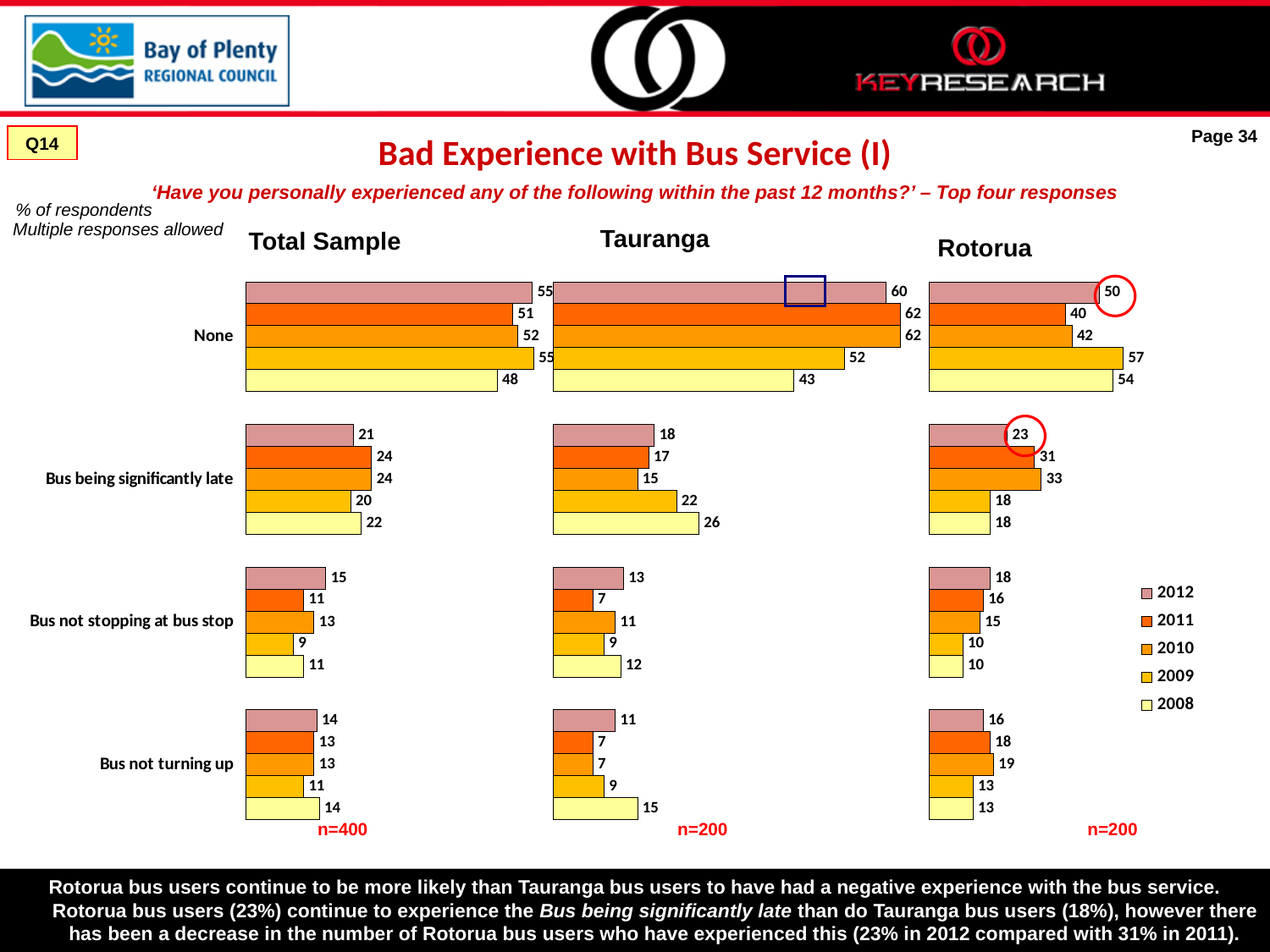
What is the sample size (n) shown under the Total Sample chart? n=400 For 'Bus being significantly late' in 2012, which is larger: the Rotorua value or the Tauranga value? Rotorua In the Total Sample chart, what is the 2009 value for 'Bus not stopping at bus stop'? 9 How many series does the legend list? 5 In the Rotorua chart, what is the 2012 value for 'Bus being significantly late'? 23 How many response categories are shown in the Total Sample chart? 4 In the Rotorua chart, what is the difference between the 2011 and 2012 values for 'Bus being significantly late'? 8 In the Rotorua chart, which year has the highest value for 'None'? 2009 What kind of chart is used for the Tauranga data? Bar chart In the Tauranga chart, what is the 2010 value for 'Bus not stopping at bus stop'? 11 In the Tauranga chart, what is the 2008 value for 'None'? 43 In the Tauranga chart, which year has the lowest value for 'Bus not turning up'? 2010 and 2011 (tied at 7)